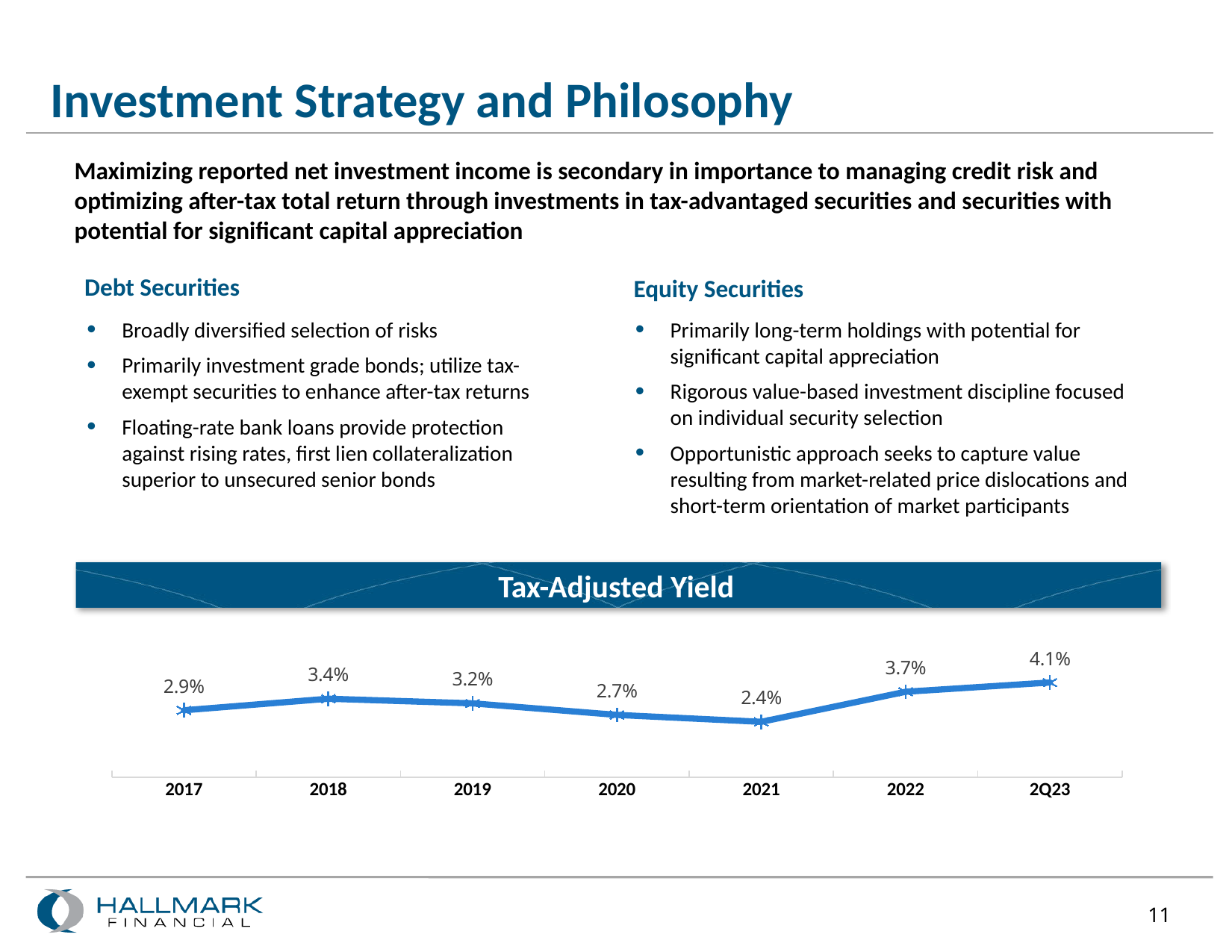
What kind of chart is the Tax-Adjusted Yield chart? Line chart Which period has the lowest tax-adjusted yield? 2021 Which is larger, the tax-adjusted yield in 2018 or in 2022? 2022 What is the tax-adjusted yield for 2Q23? 4.1% Which period has the highest tax-adjusted yield? 2Q23 What is the tax-adjusted yield for 2021? 2.4% How many periods are plotted in the Tax-Adjusted Yield chart? 7 What is the difference between the tax-adjusted yield in 2018 and in 2020? 0.7% What is the tax-adjusted yield for 2017? 2.9% What is the tax-adjusted yield for 2019? 3.2% Does the tax-adjusted yield rise or fall from 2021 to 2Q23? Rise What is the difference between the tax-adjusted yield in 2Q23 and in 2021? 1.7%